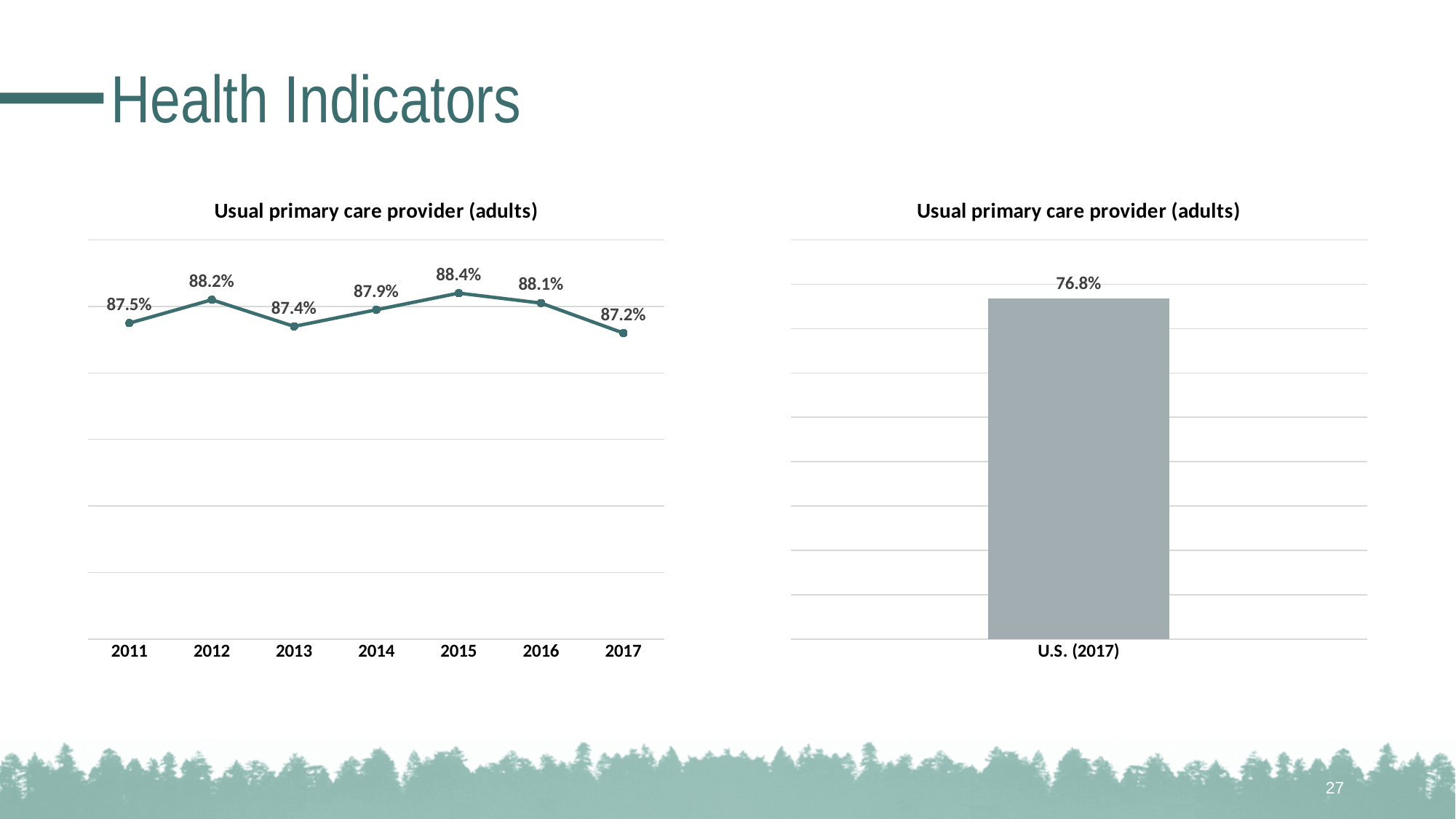
In the left chart, what is the difference between the values for 2015 and 2017? 1.2% In the left chart, which is larger, the value for 2012 or the value for 2014? 2012 What kind of chart is the right chart? bar chart In the left chart, which year has the highest value? 2015 What is the title of the right chart? Usual primary care provider (adults) In the left chart, which year has the lowest value? 2017 In the right chart, what is the value for U.S. (2017)? 76.8% What kind of chart is the left chart? line chart In the left chart, does the value rise or fall from 2016 to 2017? fall In the left chart, how many years are plotted? 7 In the left chart, what is the value for 2011? 87.5% In the left chart, what is the value for 2015? 88.4%